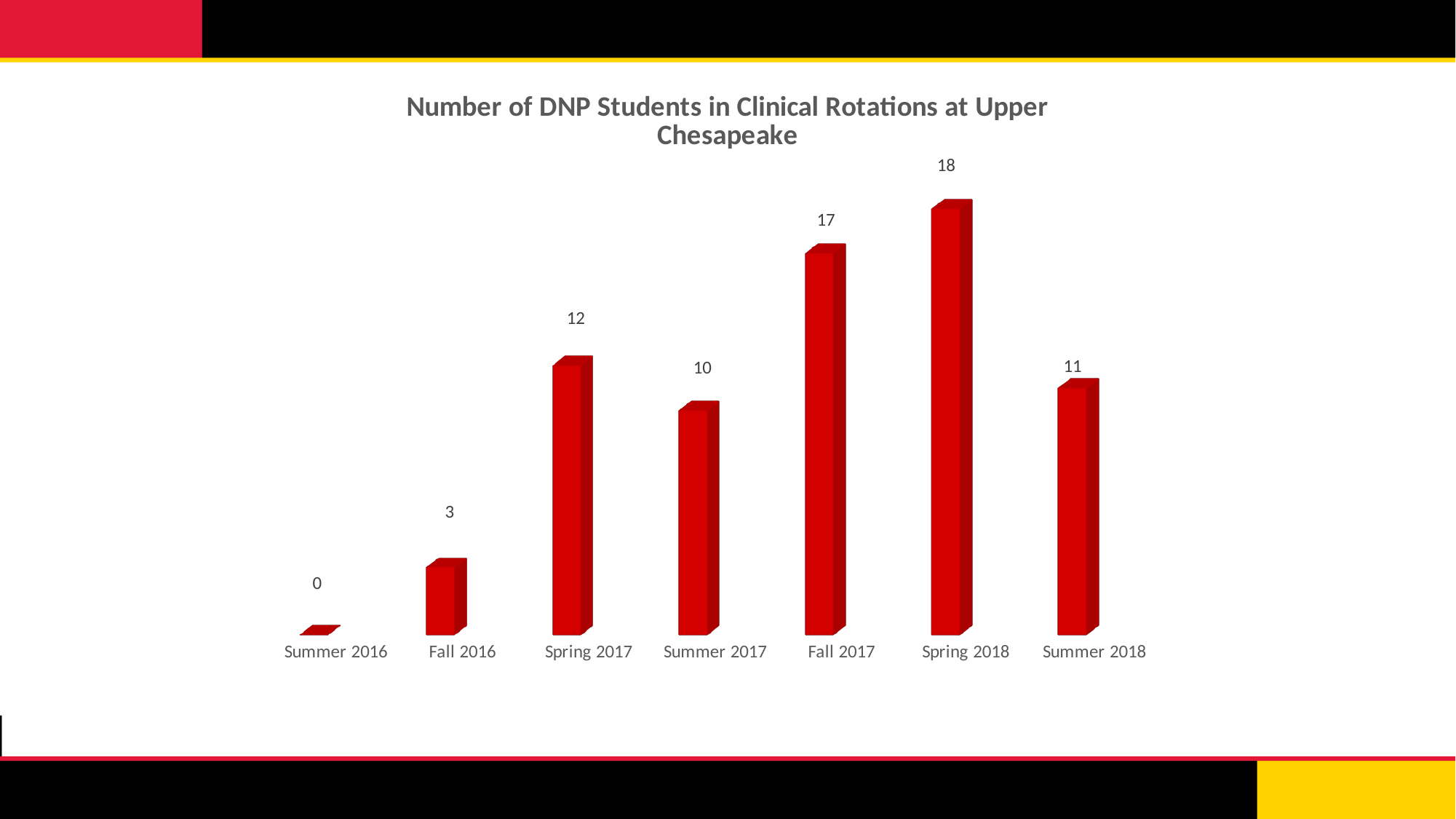
What is the value shown for Fall 2016? 3 What is the title of the chart? Number of DNP Students in Clinical Rotations at Upper Chesapeake What is the number of DNP students in clinical rotations for Spring 2017? 12 What is the value shown for Summer 2018? 11 What is the difference between the values for Spring 2018 and Fall 2017? 1 Do the values rise or fall from Summer 2016 to Spring 2018? Rise What is the difference between the values for Spring 2017 and Summer 2017? 2 Which is larger, the value for Fall 2017 or the value for Summer 2018? Fall 2017 Which term has the highest number of DNP students in clinical rotations? Spring 2018 What kind of chart is shown on the slide? Bar chart Which term has the lowest number of DNP students in clinical rotations? Summer 2016 How many terms are shown on the x axis of the chart? 7